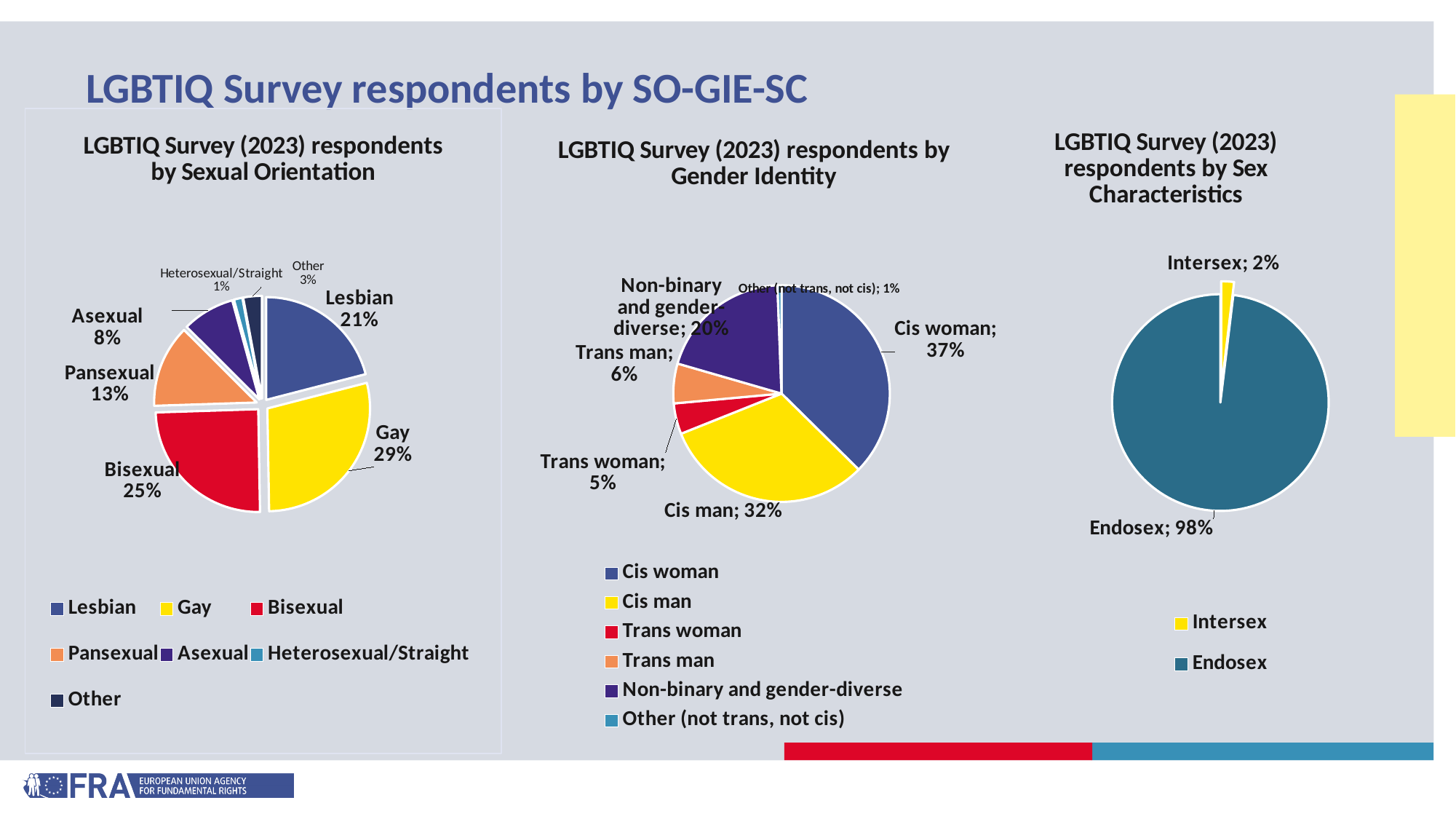
In the 'LGBTIQ Survey (2023) respondents by Gender Identity' chart, what is the combined share of Cis woman and Cis man? 69% In the 'LGBTIQ Survey (2023) respondents by Gender Identity' chart, which is larger: Trans man or Trans woman? Trans man In the 'LGBTIQ Survey (2023) respondents by Sexual Orientation' chart, what is the difference between the Bisexual and Pansexual shares? 12 percentage points In the 'LGBTIQ Survey (2023) respondents by Sexual Orientation' chart, which category has the largest share? Gay In the 'LGBTIQ Survey (2023) respondents by Sexual Orientation' chart, which category has the smallest share? Heterosexual/Straight In the 'LGBTIQ Survey (2023) respondents by Sex Characteristics' chart, what colour is the Endosex slice? Teal In the 'LGBTIQ Survey (2023) respondents by Gender Identity' chart, what share of respondents are Cis woman? 37% In the 'LGBTIQ Survey (2023) respondents by Sex Characteristics' chart, what share of respondents are Intersex? 2% In the 'LGBTIQ Survey (2023) respondents by Sexual Orientation' chart, how many categories does the legend list? 7 In the 'LGBTIQ Survey (2023) respondents by Gender Identity' chart, what share is Non-binary and gender-diverse? 20% In the 'LGBTIQ Survey (2023) respondents by Sexual Orientation' chart, what share of respondents are Gay? 29% What type of chart is the 'LGBTIQ Survey (2023) respondents by Sex Characteristics' chart? Pie chart